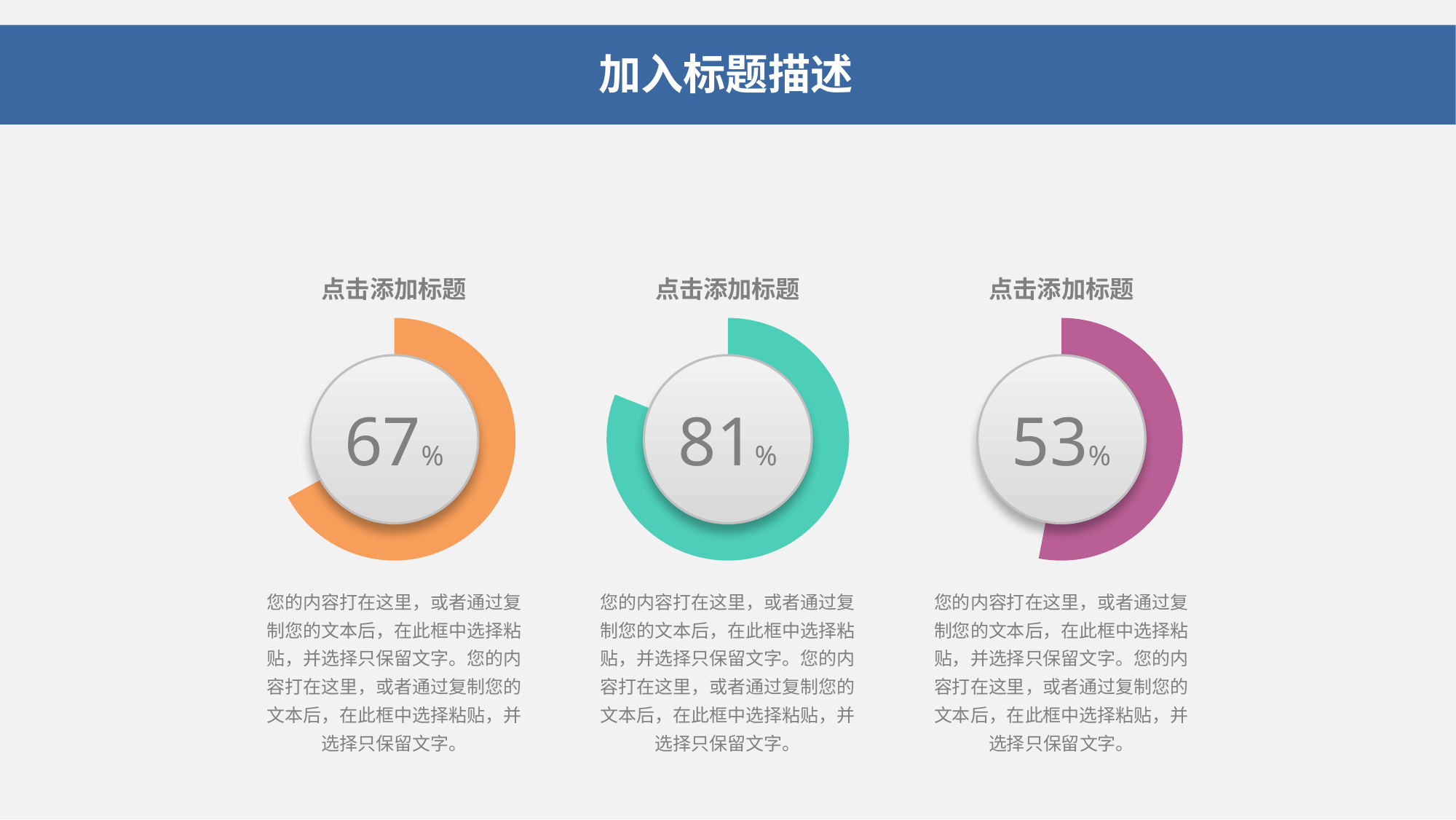
What value is shown in the left chart? 67% What kind of chart is used to display the percentages on the slide? donut chart What colour is the ring of the middle chart? teal Which of the three charts shows the lowest percentage: left, middle, or right? right How many percentage charts are on the slide? 3 What is the difference between the value in the left chart and the value in the right chart? 14% Is the value in the right chart greater or less than 50%? greater Which is larger, the value in the left chart or the value in the middle chart? middle chart What is the difference between the value in the middle chart and the value in the right chart? 28% What value is shown in the middle chart? 81% Which of the three charts shows the highest percentage: left, middle, or right? middle What value is shown in the right chart? 53%